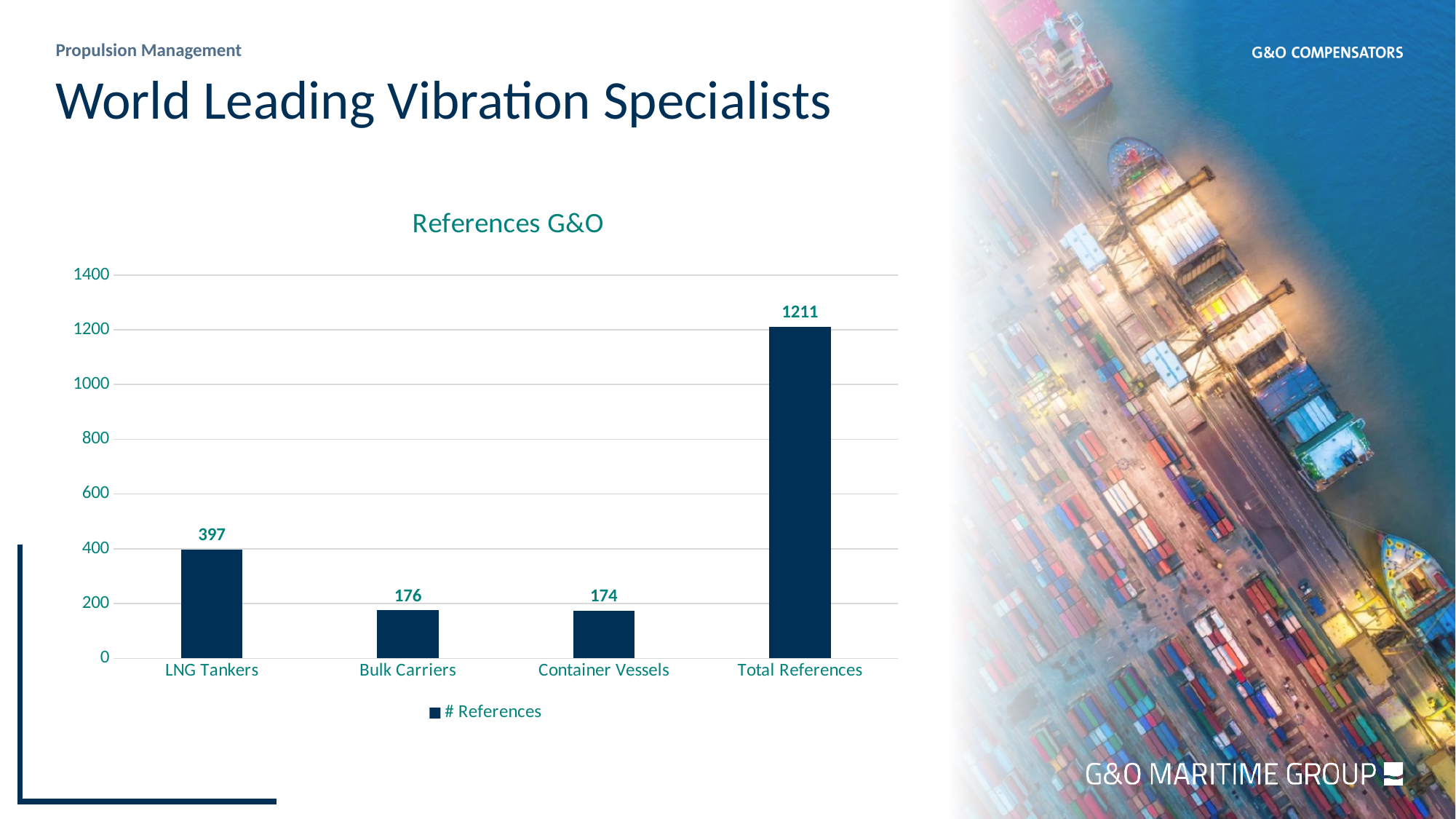
What kind of chart is shown? bar chart What is the value for Total References? 1211 How many categories are shown on the x axis? 4 What is the value for Container Vessels? 174 What is the value for LNG Tankers? 397 Which category has the lowest value? Container Vessels What is the difference between the values for LNG Tankers and Bulk Carriers? 221 What is the value for Bulk Carriers? 176 Is the value for Total References greater or less than 1000? greater Which is larger, the value for LNG Tankers or the value for Container Vessels? LNG Tankers What is the title of the chart? References G&O Which category has the highest value? Total References